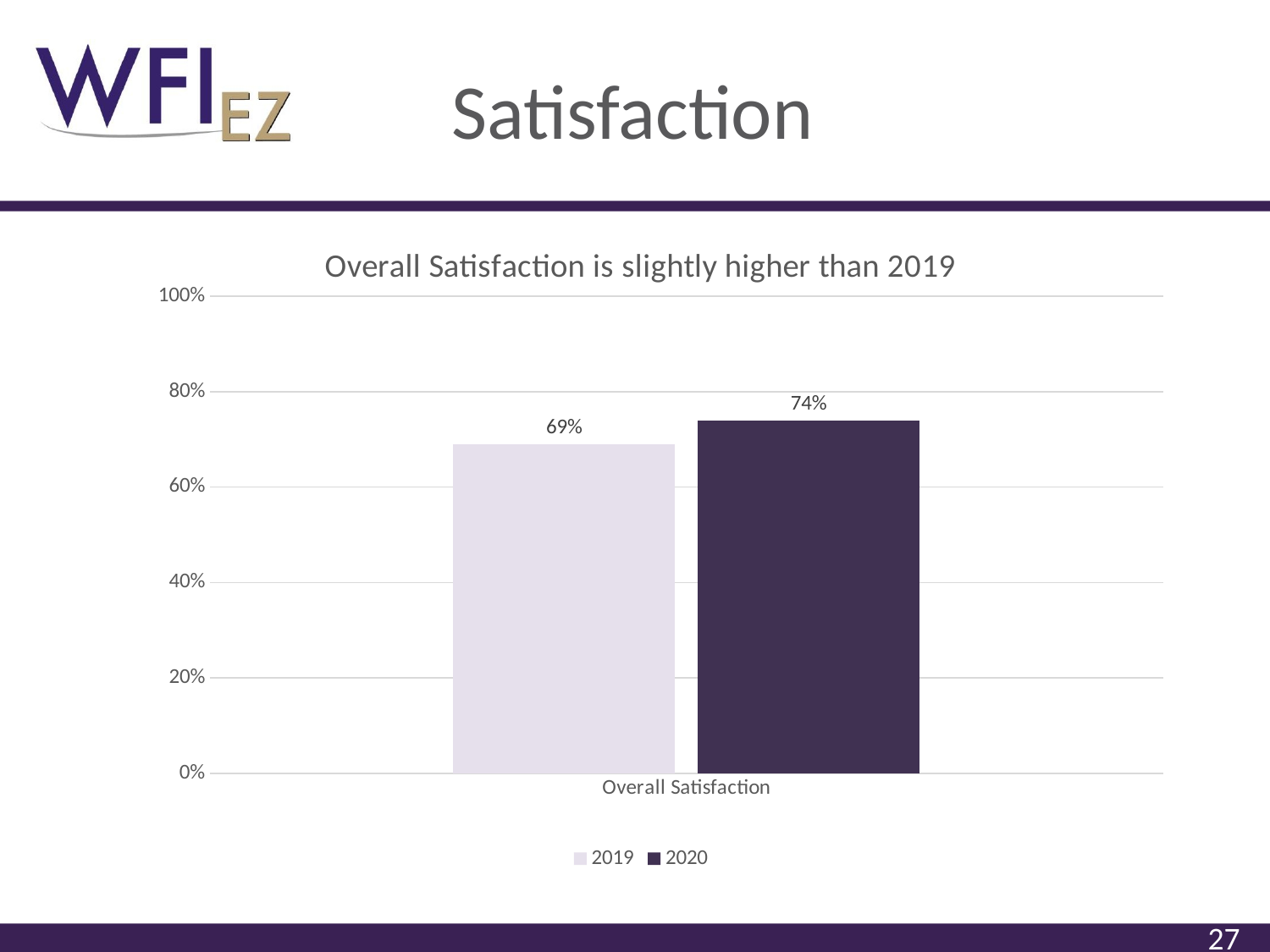
Which year has the higher Overall Satisfaction value? 2020 Which year has the lower Overall Satisfaction value? 2019 How many series does the legend list? 2 Is the Overall Satisfaction value for 2020 larger than the value for 2019? Yes Is the Overall Satisfaction value for 2019 greater or less than 80%? less What is the Overall Satisfaction value for 2020? 74% What kind of chart is shown on the slide? Bar chart What is the title of the chart? Overall Satisfaction is slightly higher than 2019 Is the Overall Satisfaction value for 2020 greater or less than 60%? greater How many categories are shown on the x axis? 1 What is the Overall Satisfaction value for 2019? 69% What is the difference between the 2020 and 2019 Overall Satisfaction values? 5%